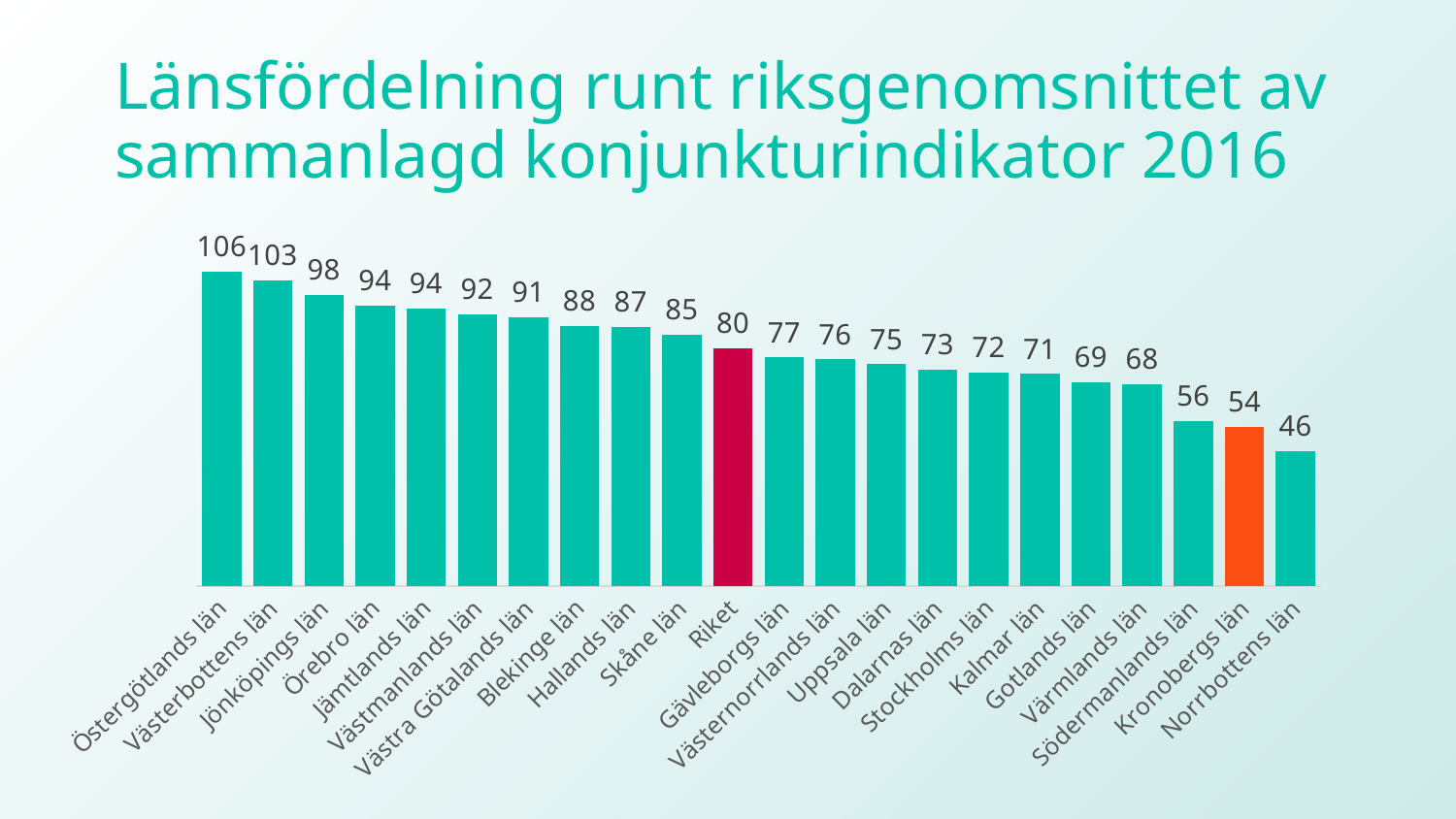
Which is larger, the value for Uppsala län or the value for Gotlands län? Uppsala län Which category has the highest value? Östergötlands län What is the difference between the values for Östergötlands län and Norrbottens län? 60 What kind of chart is shown on the slide? Bar chart What is the value for Stockholms län? 72 Which category has the lowest value? Norrbottens län Which bar is coloured red in the chart? Riket What is the value for Riket? 80 What is the value for Östergötlands län? 106 What is the difference between the values for Skåne län and Riket? 5 What is the value for Kronobergs län? 54 How many bars are shown in the chart? 22